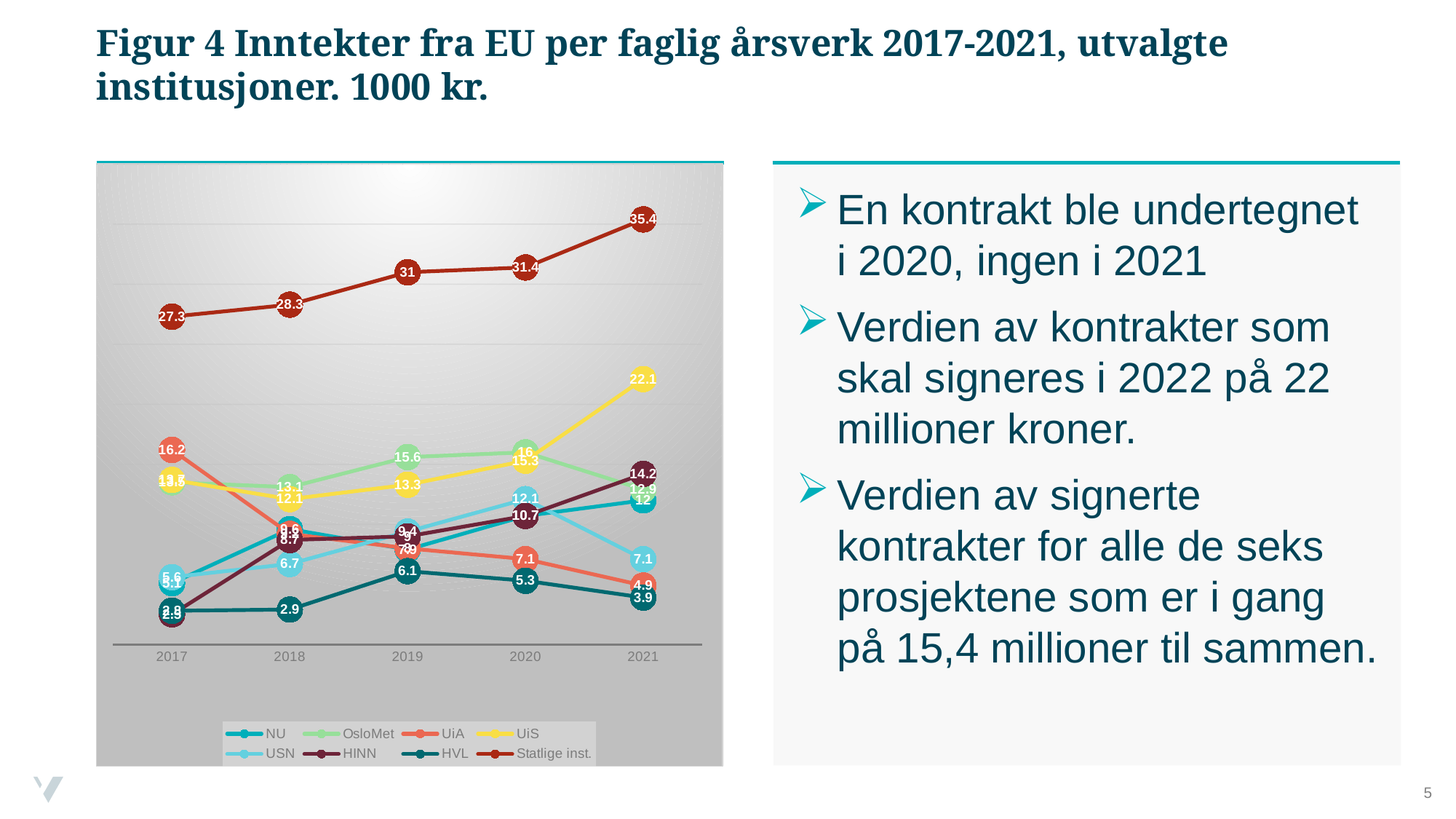
What is the difference between the Statlige inst. values in 2021 and 2017? 8.1 Does the Statlige inst. series rise or fall from 2017 to 2021? rise How many years are shown on the x axis? 5 Which series has the highest value in 2021? Statlige inst. Which is larger in 2020, the value for OsloMet or the value for HINN? OsloMet What is the value for UiS in 2021? 22.1 What is the value for UiA in 2017? 16.2 How many series does the legend list? 8 What is the value for HVL in 2018? 2.9 Which series has the lowest value in 2021? HVL What type of chart is shown on the slide? line chart What is the value for Statlige inst. in 2021? 35.4